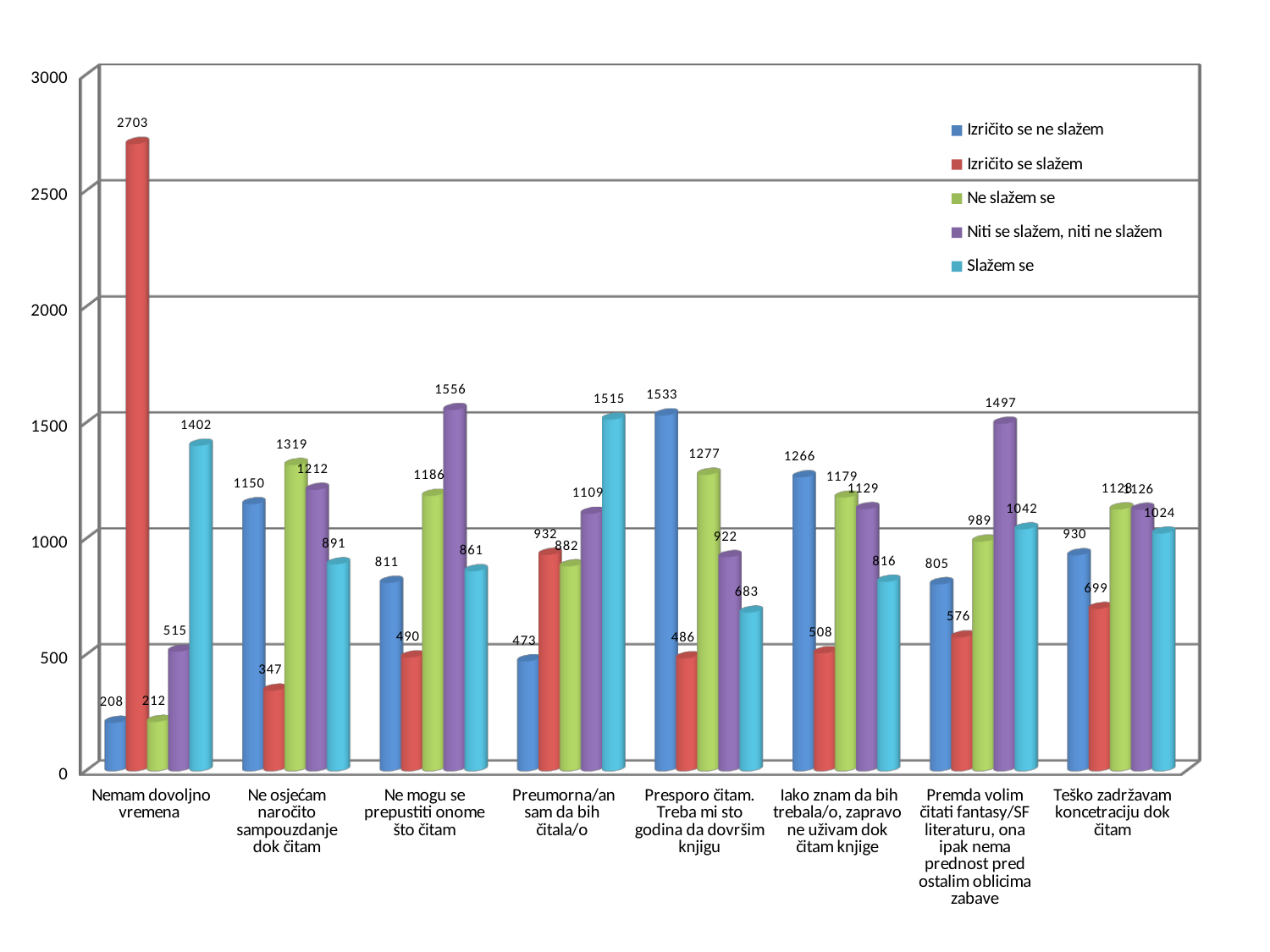
For "Ne osjećam naročito sampouzdanje dok čitam", which is larger: "Ne slažem se" or "Slažem se"? Ne slažem se How many series does the legend list? 5 Which category has the lowest value for "Izričito se ne slažem"? Nemam dovoljno vremena How many categories are shown on the x axis? 8 Is the value of "Niti se slažem, niti ne slažem" for "Premda volim čitati fantasy/SF literaturu, ona ipak nema prednost pred ostalim oblicima zabave" greater or less than 1000? greater What is the difference between "Izričito se slažem" and "Izričito se ne slažem" for "Nemam dovoljno vremena"? 2495 What is the value of "Izričito se ne slažem" for "Presporo čitam. Treba mi sto godina da dovršim knjigu"? 1533 What is the value of "Izričito se slažem" for "Nemam dovoljno vremena"? 2703 What kind of chart is shown on the slide? Bar chart What is the value of "Slažem se" for "Preumorna/an sam da bih čitala/o"? 1515 What is the value of "Niti se slažem, niti ne slažem" for "Ne mogu se prepustiti onome što čitam"? 1556 Which category has the highest value for "Izričito se slažem"? Nemam dovoljno vremena